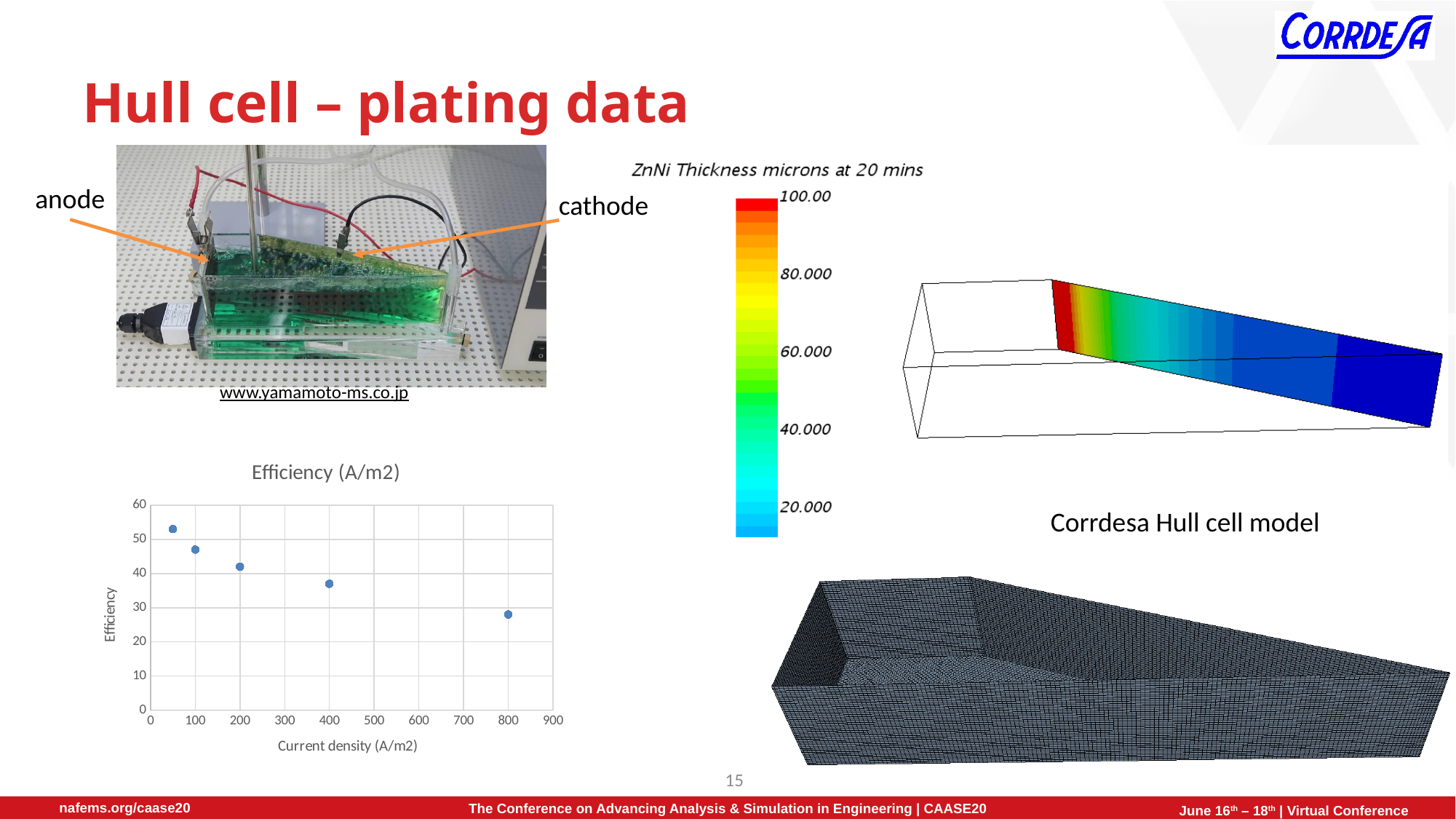
On the "Efficiency (A/m2)" chart, at which current density is efficiency lowest? 800 On the "Efficiency (A/m2)" chart, is the efficiency at a current density of 400 greater or less than 40? less What is the maximum value shown on the y-axis of the "Efficiency (A/m2)" chart? 60 On the "Efficiency (A/m2)" chart, is the efficiency at a current density of 200 greater or less than 50? less What kind of chart is the "Efficiency (A/m2)" chart? scatter chart On the "Efficiency (A/m2)" chart, does efficiency rise or fall as current density increases? fall On the "Efficiency (A/m2)" chart, is the efficiency at a current density of 800 greater or less than 30? less How many data points are plotted on the "Efficiency (A/m2)" chart? 5 On the "Efficiency (A/m2)" chart, which has the higher efficiency: a current density of 100 or 400? 100 What is the x-axis label of the "Efficiency (A/m2)" chart? Current density (A/m2)